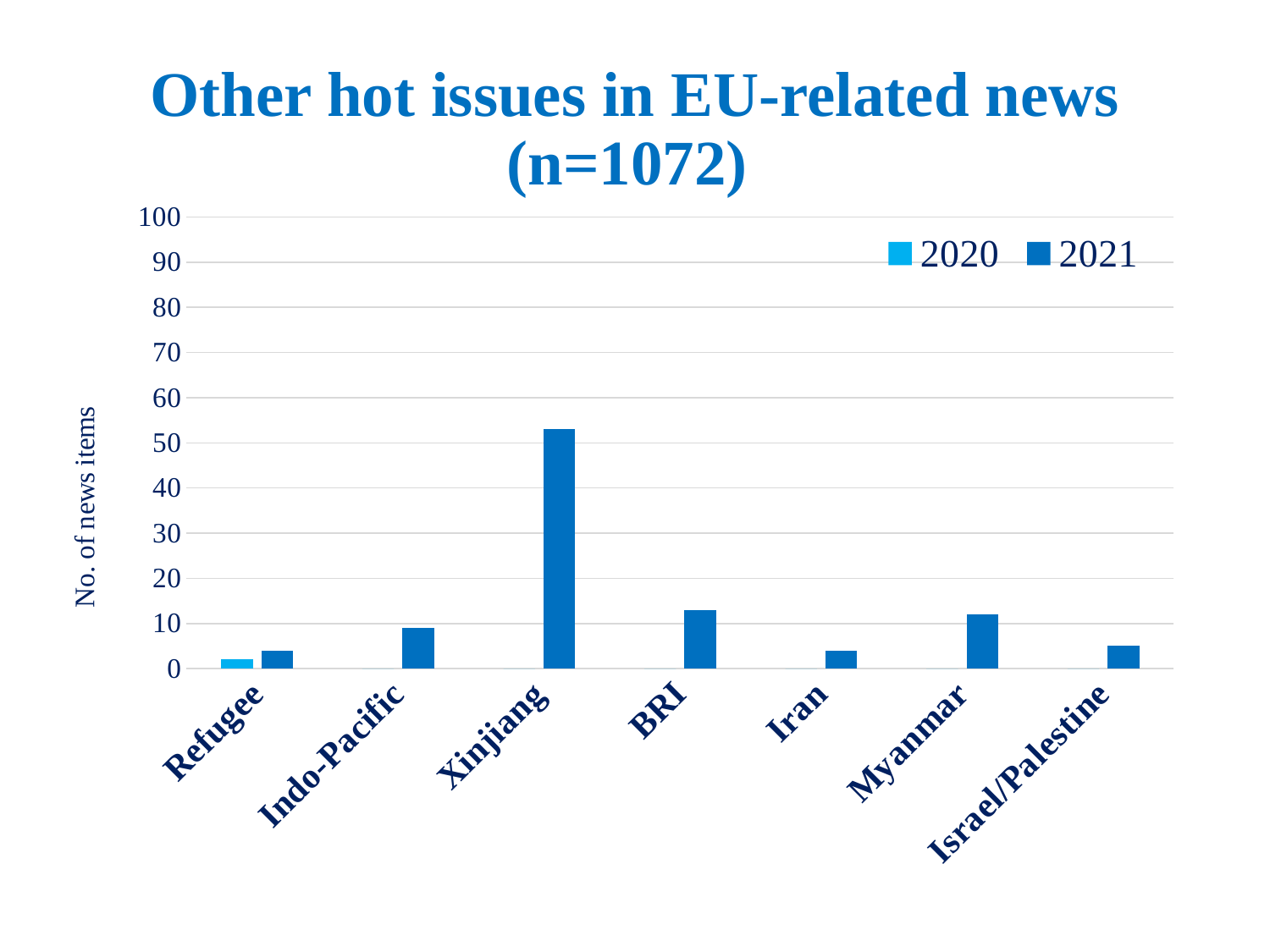
How many categories are shown on the x axis? 7 Is the 2021 value for Xinjiang greater or less than 40? greater Which category has the highest value for 2021? Xinjiang What is the title of the chart? Other hot issues in EU-related news (n=1072) Which is larger for 2021, Myanmar or Israel/Palestine? Myanmar How many series does the legend list? 2 Is the 2021 value for BRI greater or less than 10? greater Is the 2021 value for Israel/Palestine greater or less than 10? less What type of chart is shown on the slide? bar chart Which is larger for 2021, BRI or Indo-Pacific? BRI What is the label of the vertical axis? No. of news items